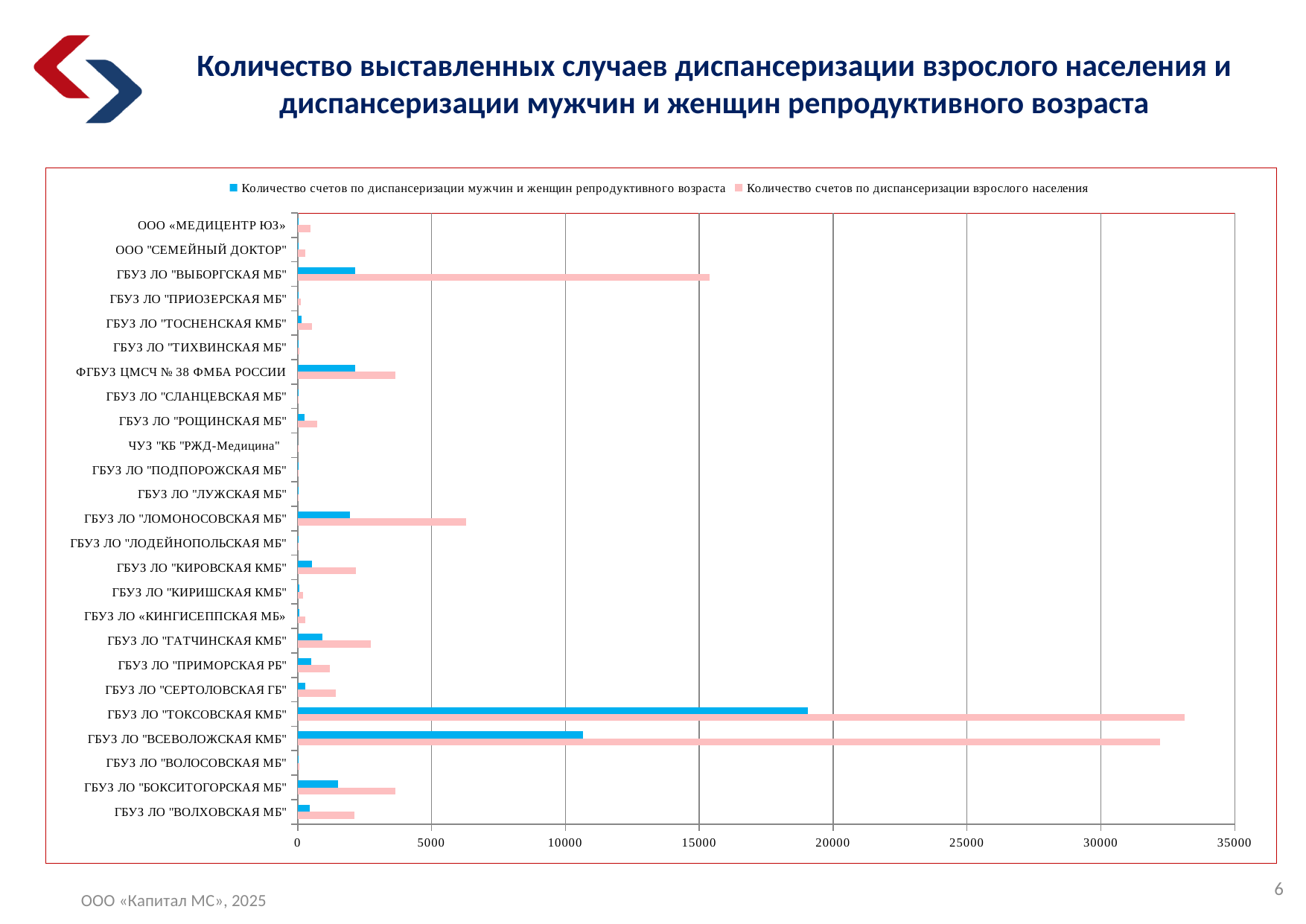
How many organizations (categories) are shown on the chart? 25 In the series "Количество счетов по диспансеризации взрослого населения", which is larger: ГБУЗ ЛО "ВЫБОРГСКАЯ МБ" or ФГБУЗ ЦМСЧ № 38 ФМБА РОССИИ? ГБУЗ ЛО "ВЫБОРГСКАЯ МБ" Which colour represents the series "Количество счетов по диспансеризации взрослого населения" in the legend? pink In the series "Количество счетов по диспансеризации мужчин и женщин репродуктивного возраста", which is larger: ГБУЗ ЛО "ТОКСОВСКАЯ КМБ" or ГБУЗ ЛО "ВСЕВОЛОЖСКАЯ КМБ"? ГБУЗ ЛО "ТОКСОВСКАЯ КМБ" What kind of chart is shown on the slide? bar chart Is the value for ГБУЗ ЛО "ЛОМОНОСОВСКАЯ МБ" in the series "Количество счетов по диспансеризации взрослого населения" greater or less than 5000? greater Is the value for ГБУЗ ЛО "ТОКСОВСКАЯ КМБ" in the series "Количество счетов по диспансеризации мужчин и женщин репродуктивного возраста" greater or less than 20000? less Is the value for ГБУЗ ЛО "ТОКСОВСКАЯ КМБ" in the series "Количество счетов по диспансеризации взрослого населения" greater or less than 30000? greater Which organization has the highest value for "Количество счетов по диспансеризации мужчин и женщин репродуктивного возраста"? ГБУЗ ЛО "ТОКСОВСКАЯ КМБ" How many series does the legend list? 2